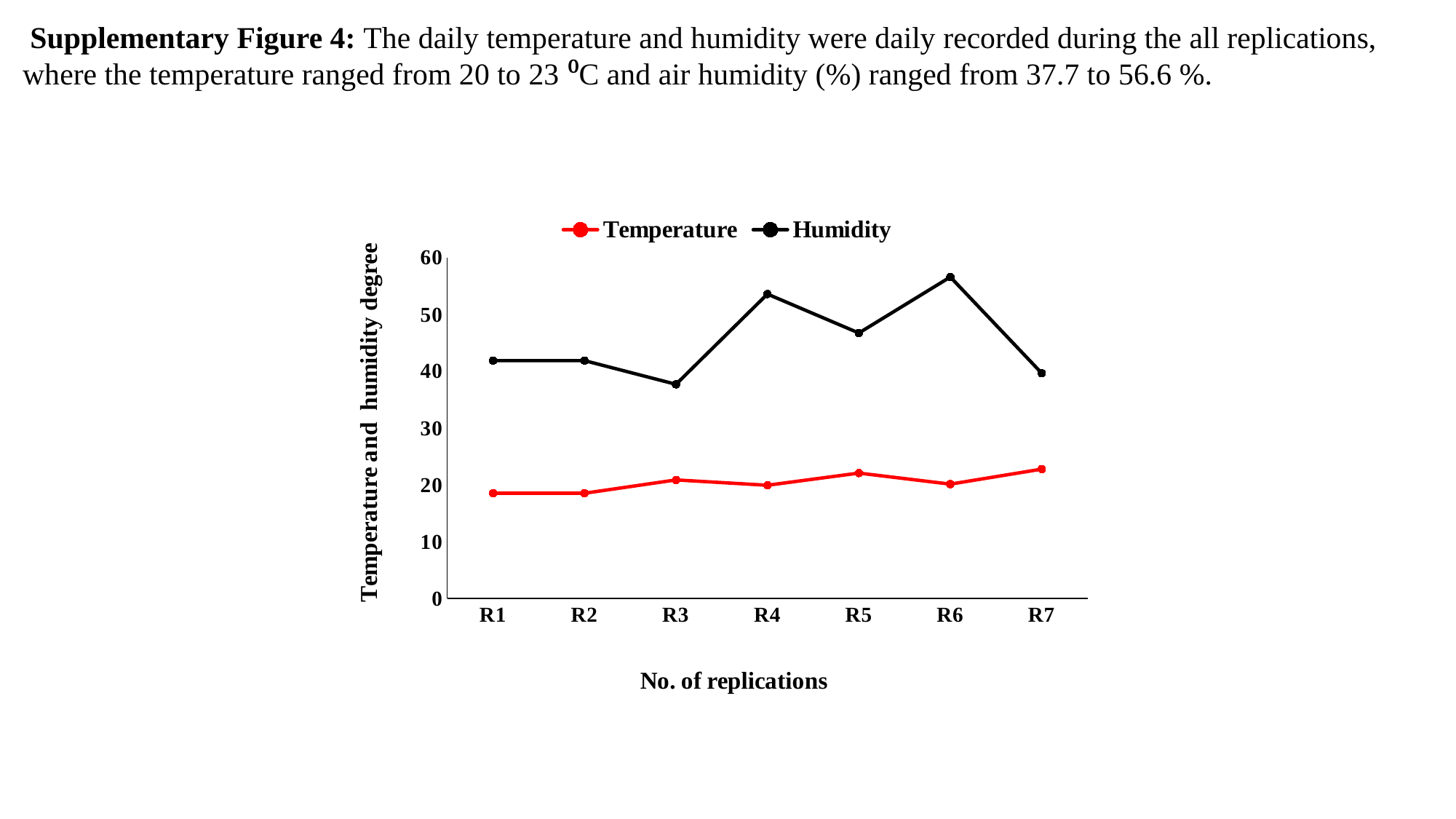
How many replications are plotted along the x axis? 7 How many series does the legend list? 2 Is the Humidity value for R5 greater or less than 50? less What colour is the Temperature line? red Does the Humidity line rise or fall from R3 to R4? rise Is the Humidity value for R4 greater or less than 50? greater Which has the higher Humidity value, R4 or R5? R4 Which has the higher Temperature value, R2 or R3? R3 At which replication is Humidity lowest? R3 Is the Temperature value for R1 greater or less than 20? less At which replication is Humidity highest? R6 What kind of chart is shown on the slide? line chart